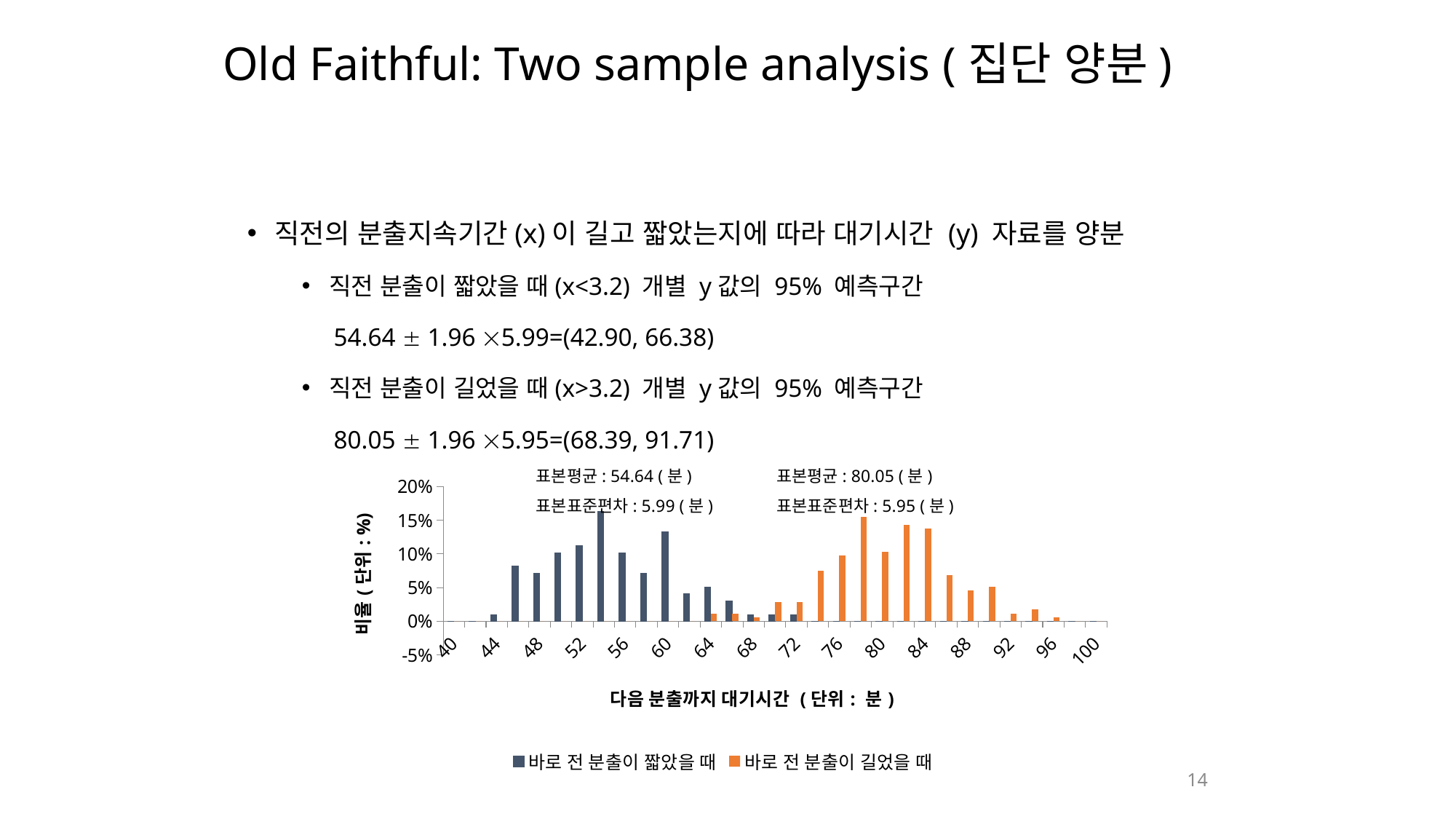
What kind of chart is shown on the slide? bar chart Is the value of the orange bar at 86 minutes greater or less than 5%? greater Is the value of the dark blue bar at 44 minutes greater or less than 5%? less What are the two series named in the chart legend? 바로 전 분출이 짧았을 때, 바로 전 분출이 길었을 때 What is the title of the chart's x axis? 다음 분출까지 대기시간 ( 단위 : 분 ) Is the value of the dark blue bar at 60 minutes greater or less than 10%? greater According to the annotation on the chart, what is the sample standard deviation (표본표준편차) for the group where the previous eruption was long? 5.95 ( 분 ) According to the annotation on the chart, what is the sample mean (표본평균) for the group where the previous eruption was short? 54.64 ( 분 ) How many series does the chart legend list? 2